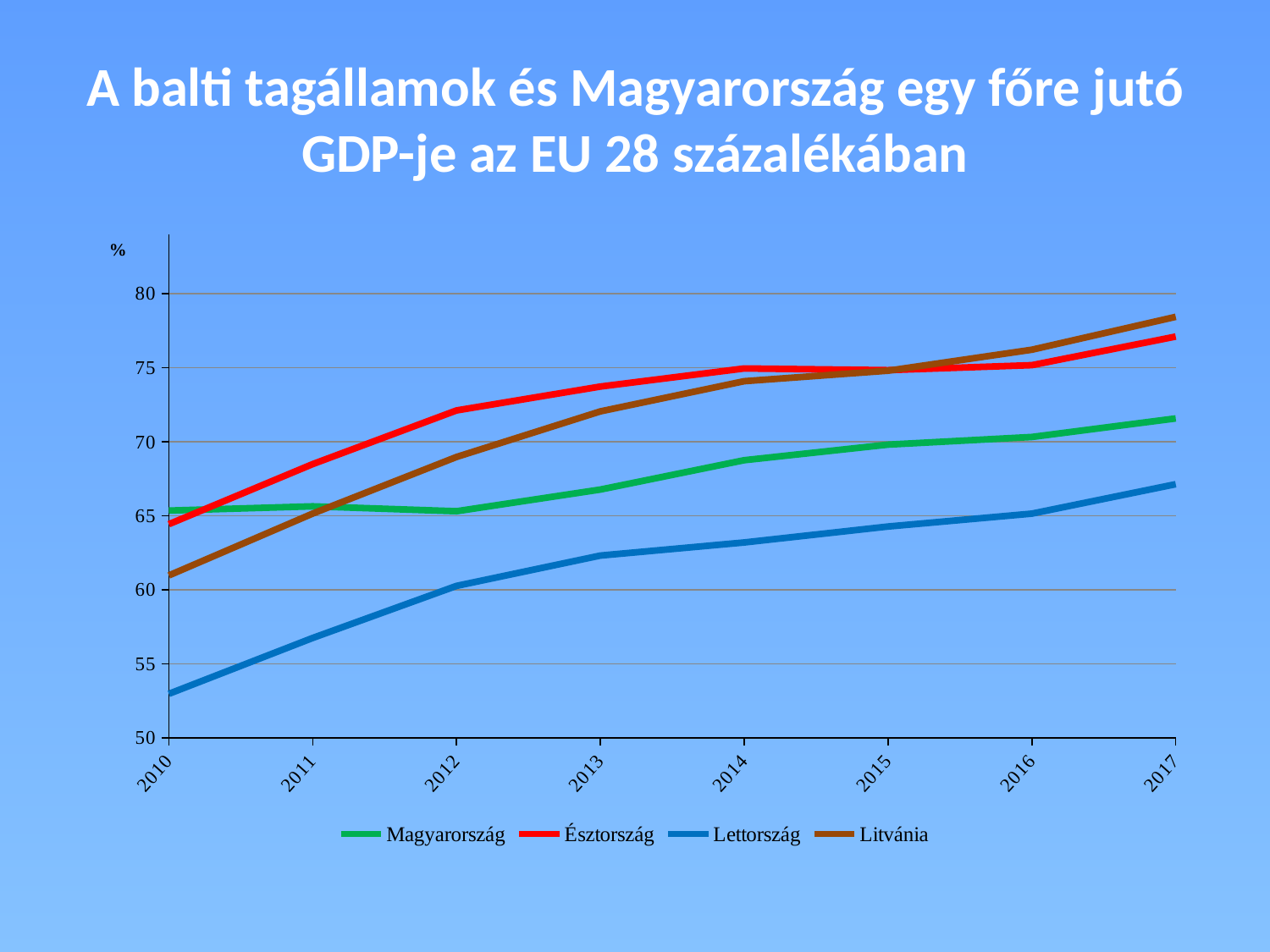
Is the value for Litvánia in 2010 greater or less than 65? less How many years are shown on the x axis? 8 In 2010, which is larger: the value for Magyarország or for Lettország? Magyarország What kind of chart is shown on the slide? line chart Is the value for Észtország in 2012 greater or less than 70? greater How many series does the legend list? 4 Which series has the highest value in 2012? Észtország Is the value for Magyarország in 2017 greater or less than 70? greater What colour is the line for Észtország? red Which series has the lowest value in 2017? Lettország Does the value for Lettország rise or fall from 2010 to 2017? rise